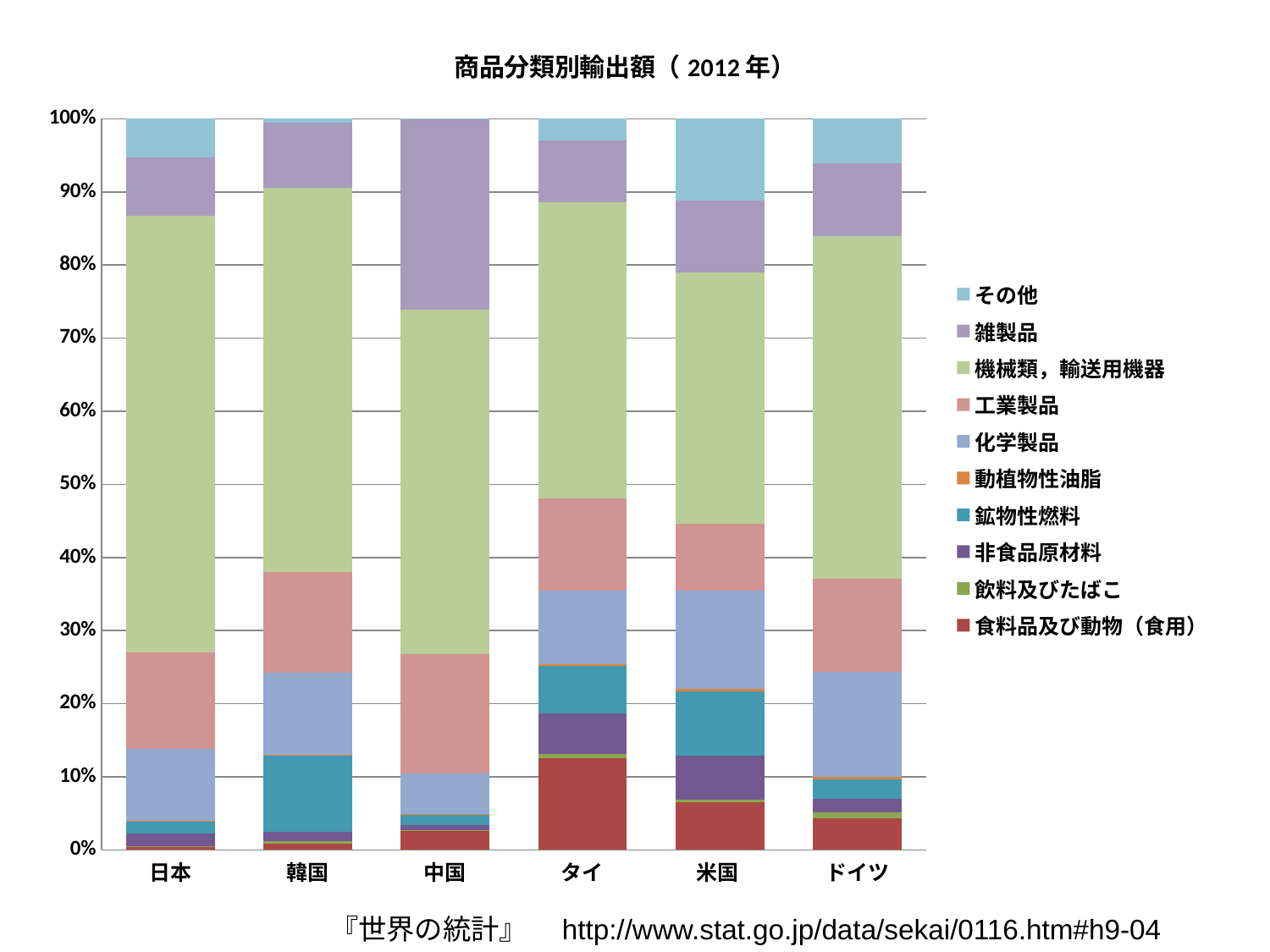
How many countries are shown on the x axis of the chart? 6 What does each stacked bar total? 100% Is the share of 化学製品 for ドイツ greater or less than 10%? greater How many series does the legend list? 10 Which has the larger share of 雑製品, 中国 or 日本? 中国 Which country has the largest share for 食料品及び動物（食用）? タイ Which country has the largest share for 雑製品? 中国 What is the title of the chart? 商品分類別輸出額（2012年） Is the share of 機械類，輸送用機器 for 米国 greater or less than 50%? less What kind of chart is shown on the slide? stacked bar chart Which country has the largest share for その他? 米国 Is the share of 機械類，輸送用機器 for 日本 greater or less than 50%? greater